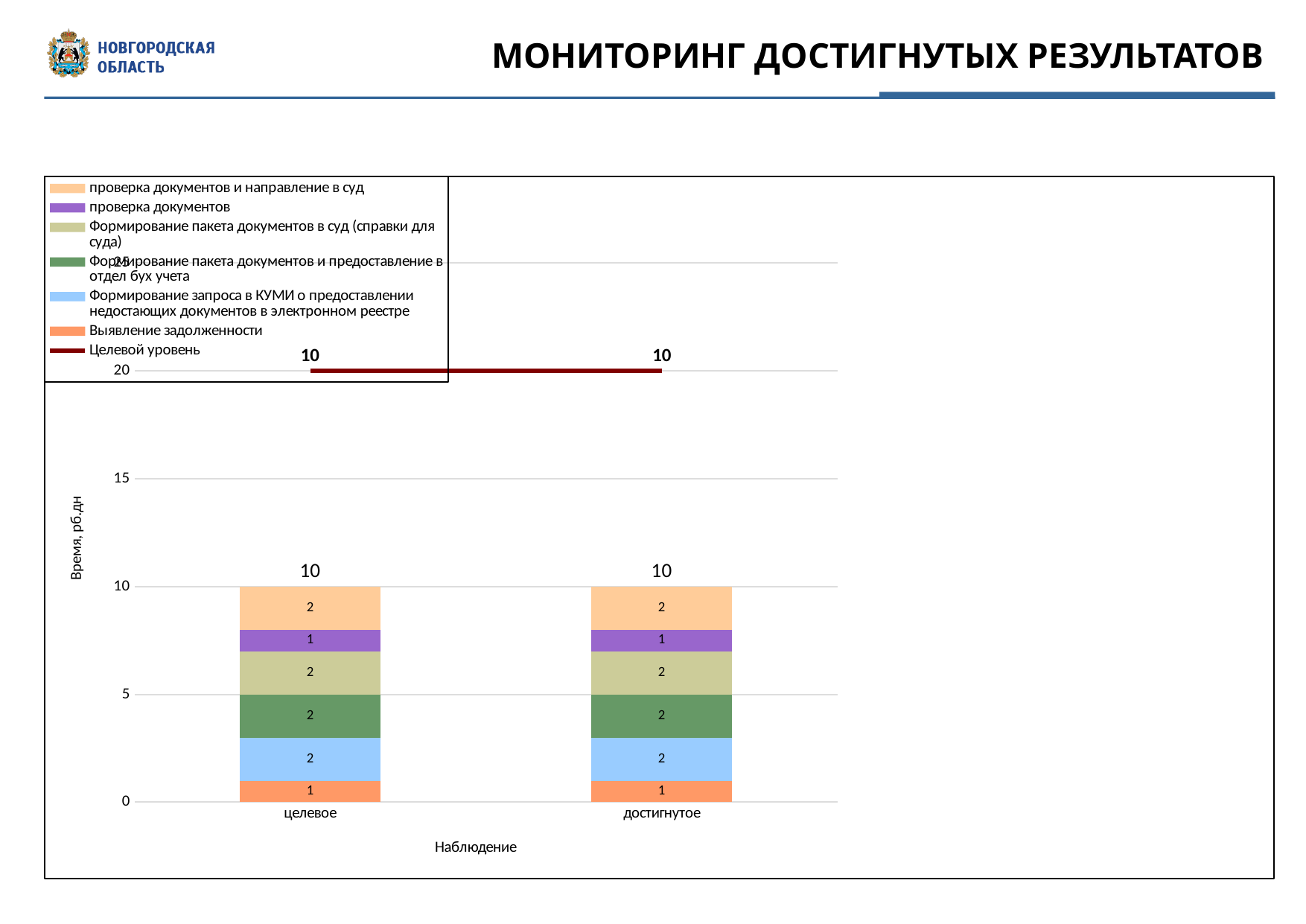
What kind of chart is shown on the slide? stacked bar chart with a line (combination bar and line chart) What is the label of the x axis of the chart? Наблюдение What is the difference between the totals of the целевое and достигнутое bars? 0 What is the value of the Выявление задолженности segment in the достигнутое bar? 1 What is the value of the Формирование запроса в КУМИ о предоставлении недостающих документов в электронном реестре segment in the целевое bar? 2 What is the value of the проверка документов и направление в суд segment in the достигнутое bar? 2 What is the total of the stacked bar for достигнутое? 10 What is the total of the stacked bar for целевое? 10 What is the value of the проверка документов segment in the целевое bar? 1 What is the label of the y axis of the chart? Время, рб.дн How many categories are shown on the x axis of the chart? 2 How many entries does the chart legend list? 7